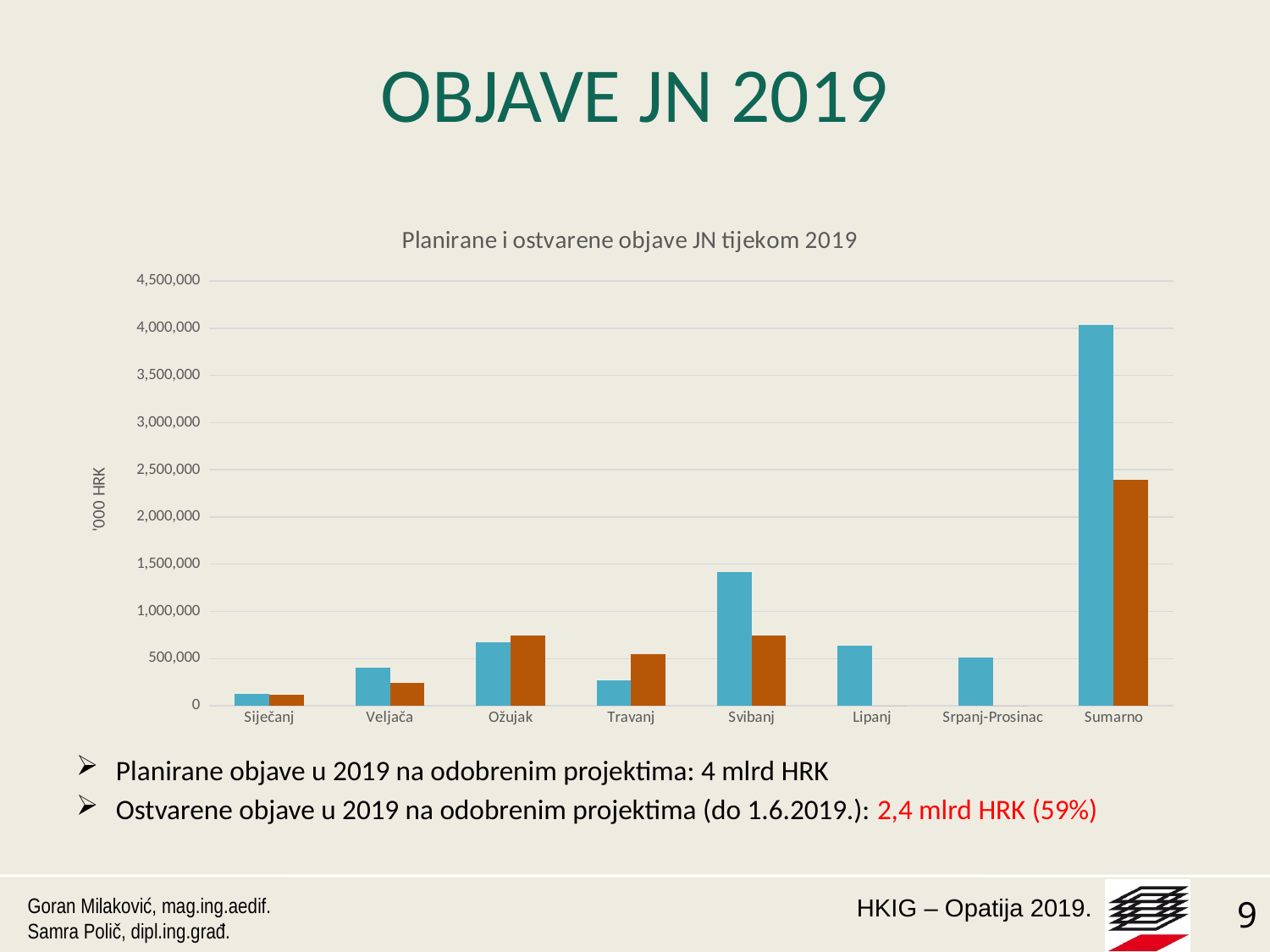
How many categories are shown on the x axis of the chart? 8 For Svibanj, which bar is taller, the blue one or the orange one? blue What is the label on the vertical axis of the chart? '000 HRK For Travanj, which bar is taller, the blue one or the orange one? orange Which category has the tallest blue bar? Sumarno Is the orange bar for Sumarno greater or less than 2,500,000? less Is the blue bar for Svibanj greater or less than 1,000,000? greater What is the title of the chart? Planirane i ostvarene objave JN tijekom 2019 Which category has the shortest blue bar? Siječanj Is the blue bar for Sumarno greater or less than 3,500,000? greater What kind of chart is shown on the slide? bar chart Among the monthly categories (excluding Sumarno), which has the tallest blue bar? Svibanj